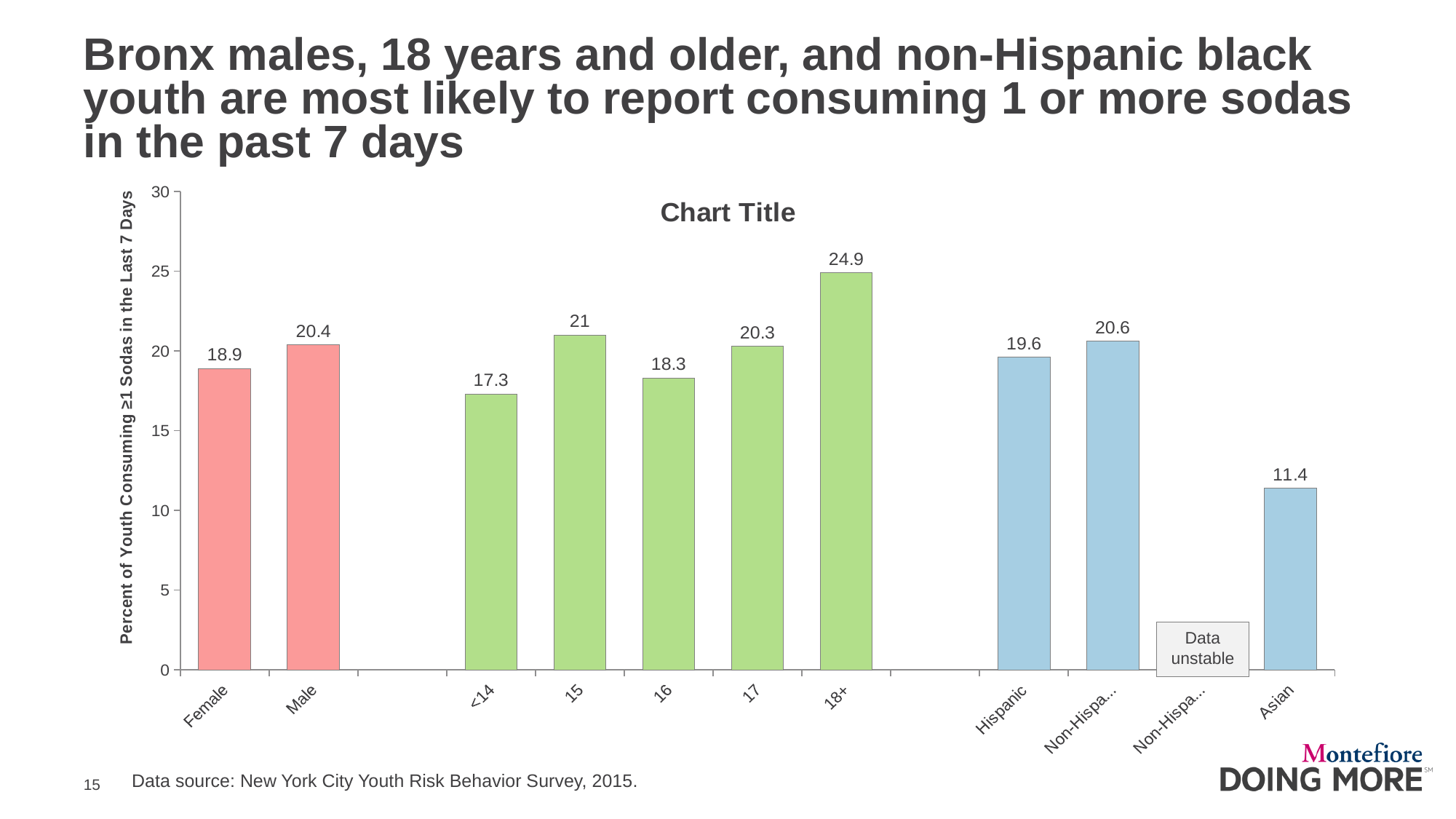
Which category has the highest value on the chart? 18+ Which has the larger value, age 15 or age 16? 15 What is the value for Asian? 11.4 Which category has the lowest plotted value on the chart? Asian What is the difference between the values for Male and Female? 1.5 What is the value for Hispanic? 19.6 What is the value for Male? 20.4 What is the title of the y axis? Percent of Youth Consuming ≥1 Sodas in the Last 7 Days Is the value for the <14 age group greater or less than 20? less What is the value for Female? 18.9 What kind of chart is shown on the slide? bar chart What is the value for the 18+ age group? 24.9